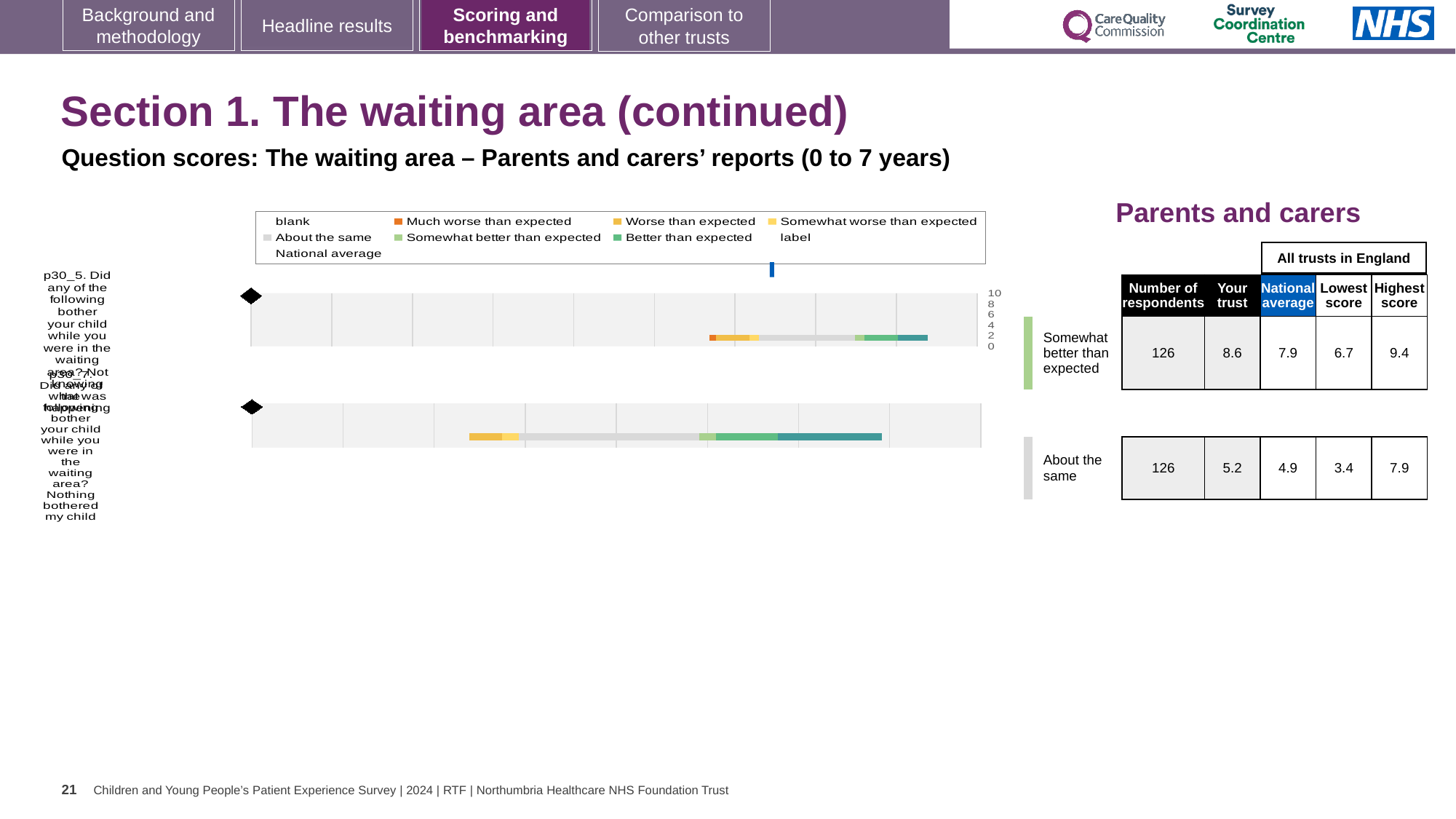
In the table beside the charts, what is the difference between the highest score and the lowest score for the top chart (p30_5)? 2.7 In the chart legend, what colour represents 'Much worse than expected'? orange For the top chart (p30_5), which is larger: the 'Your trust' score or the national average? Your trust What kind of chart is used to show the question scores on this slide? bar chart What benchmark category is given for the bottom chart (p30_7)? About the same In the table beside the charts, how many respondents are recorded for the top chart (p30_5)? 126 How many entries does the chart legend list? 9 What is the first entry listed in the chart legend? blank In the table beside the charts, what is the national average for the bottom chart (p30_7, nothing bothered my child)? 4.9 In the table beside the charts, what is the difference between the 'Your trust' score and the national average for the bottom chart (p30_7)? 0.3 How many question-score charts are shown on the slide? 2 In the table beside the charts, what is the 'Your trust' score for the top chart (p30_5, did anything bother your child in the waiting area)? 8.6